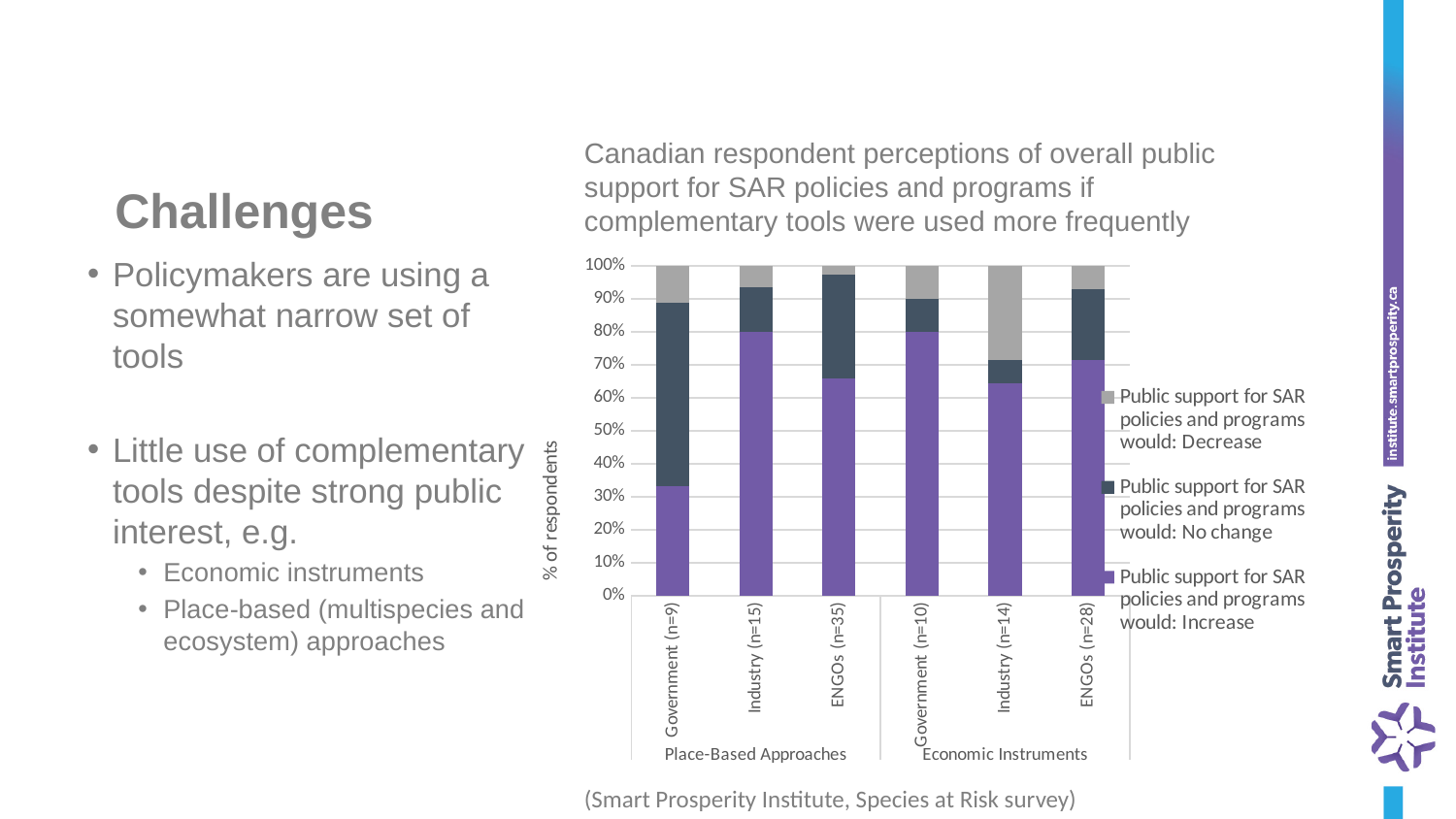
Which respondent group has the smallest 'Increase' share? Government (n=9), Place-Based Approaches Which has the larger 'Increase' share: Government (n=9) under Place-Based Approaches or Government (n=10) under Economic Instruments? Government (n=10), Economic Instruments What kind of chart is shown on the slide? Stacked bar chart Which has the larger 'Increase' share: Industry (n=15) or ENGOs (n=35) under Place-Based Approaches? Industry (n=15) Is the 'Increase' share for Government (n=9) under Place-Based Approaches greater or less than 40%? less How many series does the legend list? 3 How many bars (respondent groups) are plotted in the chart? 6 What is the label on the vertical axis of the chart? % of respondents Is the 'Increase' share for Industry (n=15) under Place-Based Approaches greater or less than 70%? greater Which respondent group has the largest 'Decrease' share? Industry (n=14), Economic Instruments What are the two category groups shown along the x axis of the chart? Place-Based Approaches and Economic Instruments Is the 'Decrease' share for Industry (n=14) under Economic Instruments greater or less than 20%? greater